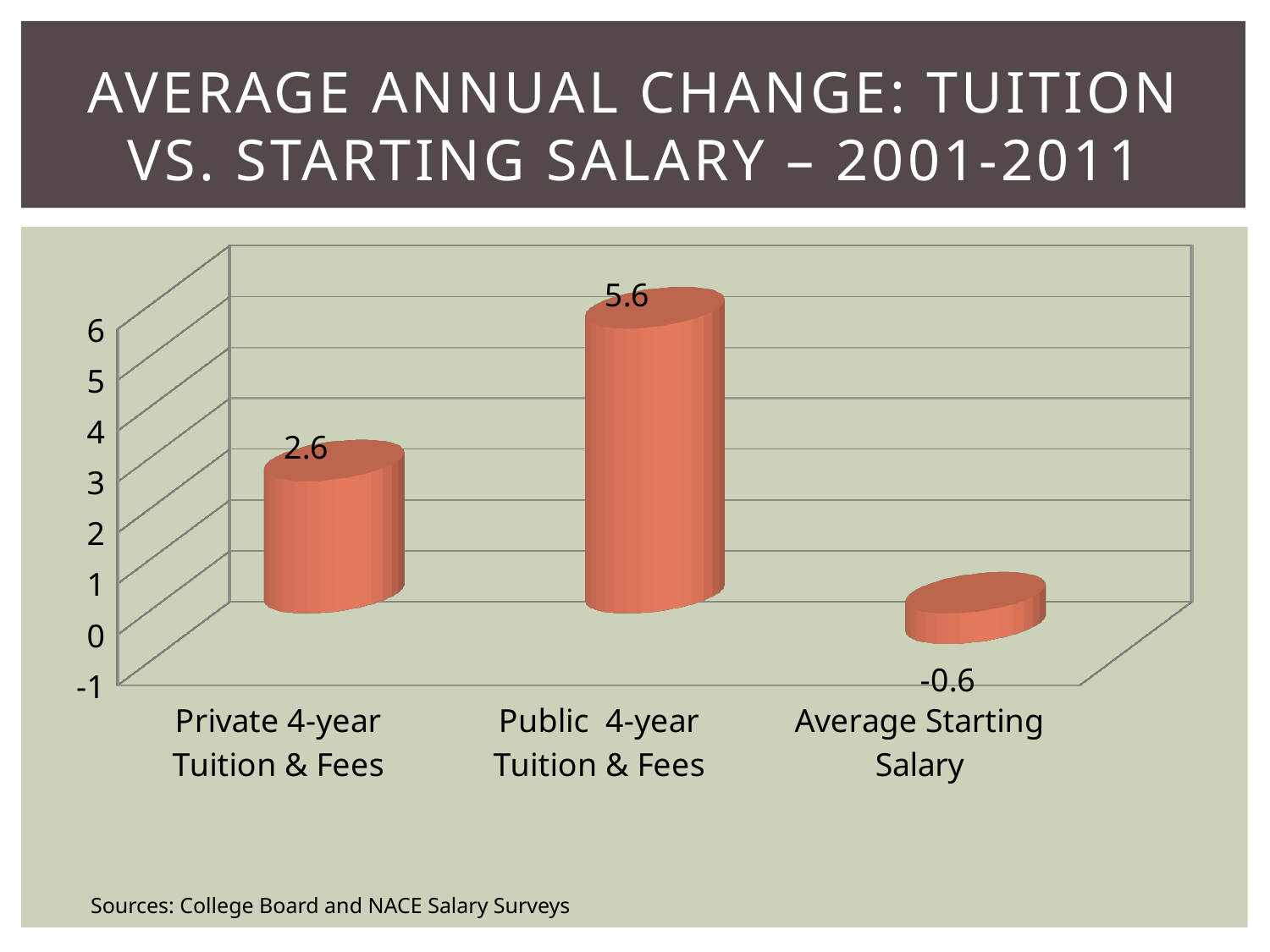
Which category has the lowest value? Average Starting Salary Which is larger, the value for Private 4-year Tuition & Fees or the value for Average Starting Salary? Private 4-year Tuition & Fees Is the value for Public 4-year Tuition & Fees greater or less than 5? greater Which category has the highest value? Public 4-year Tuition & Fees What kind of chart is shown on the slide? bar chart What is the difference between the values for Private 4-year Tuition & Fees and Average Starting Salary? 3.2 What is the value for Private 4-year Tuition & Fees? 2.6 What is the difference between the values for Public 4-year Tuition & Fees and Private 4-year Tuition & Fees? 3.0 What is the title of the slide? Average Annual Change: Tuition vs. Starting Salary – 2001-2011 How many categories are shown on the chart? 3 What is the value for Public 4-year Tuition & Fees? 5.6 What is the value for Average Starting Salary? -0.6